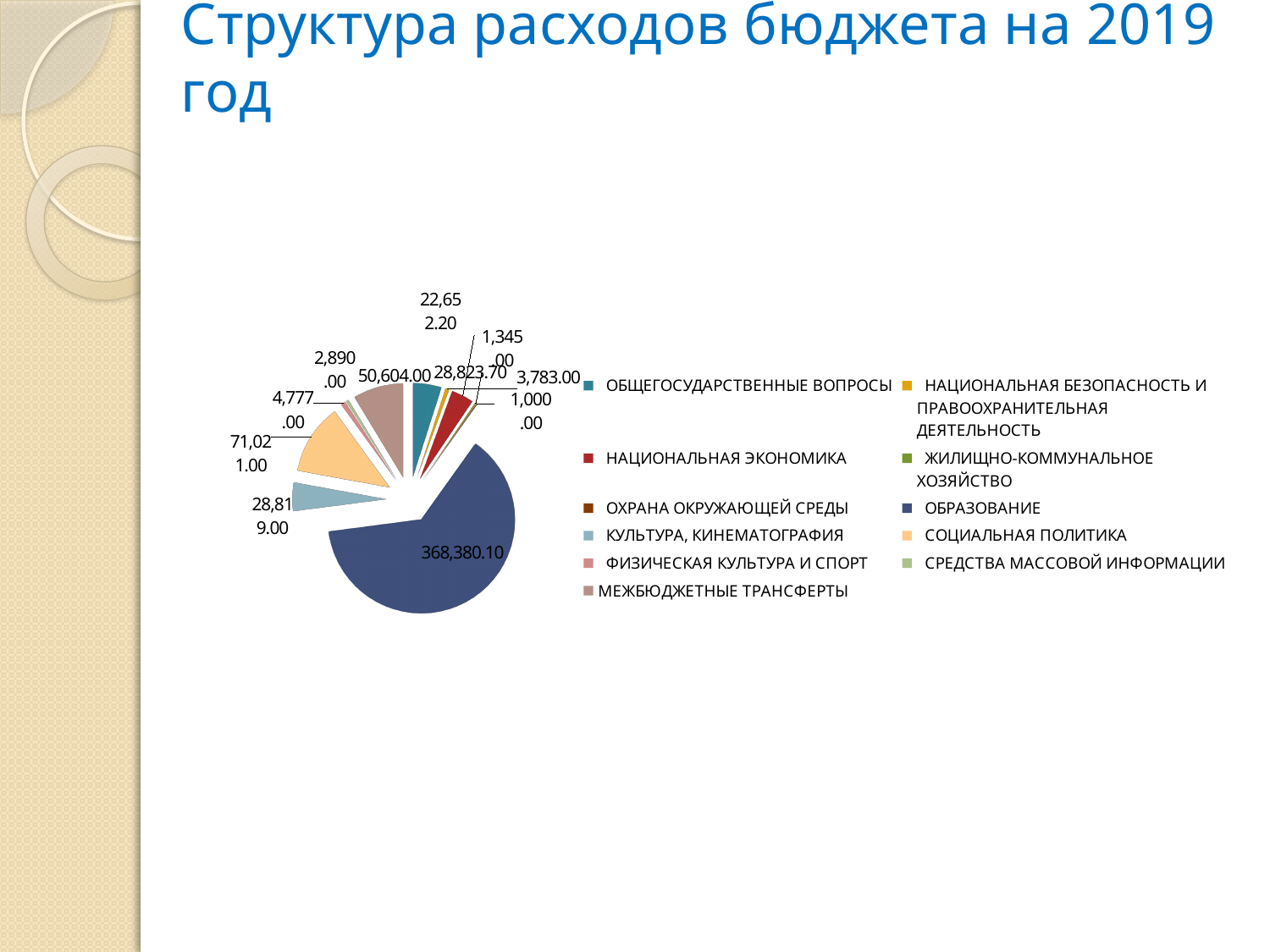
Which is larger, the value for МЕЖБЮДЖЕТНЫЕ ТРАНСФЕРТЫ or the value for ОБЩЕГОСУДАРСТВЕННЫЕ ВОПРОСЫ? МЕЖБЮДЖЕТНЫЕ ТРАНСФЕРТЫ What is the value shown for ОБРАЗОВАНИЕ? 368,380.10 Which category has the largest slice of the pie? ОБРАЗОВАНИЕ What is the difference between the values for ОБРАЗОВАНИЕ and СОЦИАЛЬНАЯ ПОЛИТИКА? 297,359.10 What is the value shown for СОЦИАЛЬНАЯ ПОЛИТИКА? 71,021.00 How many categories does the legend list? 11 What is the smallest data label value shown on the pie chart? 1,000.00 What is the title of the chart on the slide? Структура расходов бюджета на 2019 год What type of chart is shown on the slide? pie chart What is the value shown for МЕЖБЮДЖЕТНЫЕ ТРАНСФЕРТЫ? 50,604.00 What is the value shown for ОБЩЕГОСУДАРСТВЕННЫЕ ВОПРОСЫ? 28,823.70 Which is larger, the value for ОБРАЗОВАНИЕ or the value for СОЦИАЛЬНАЯ ПОЛИТИКА? ОБРАЗОВАНИЕ